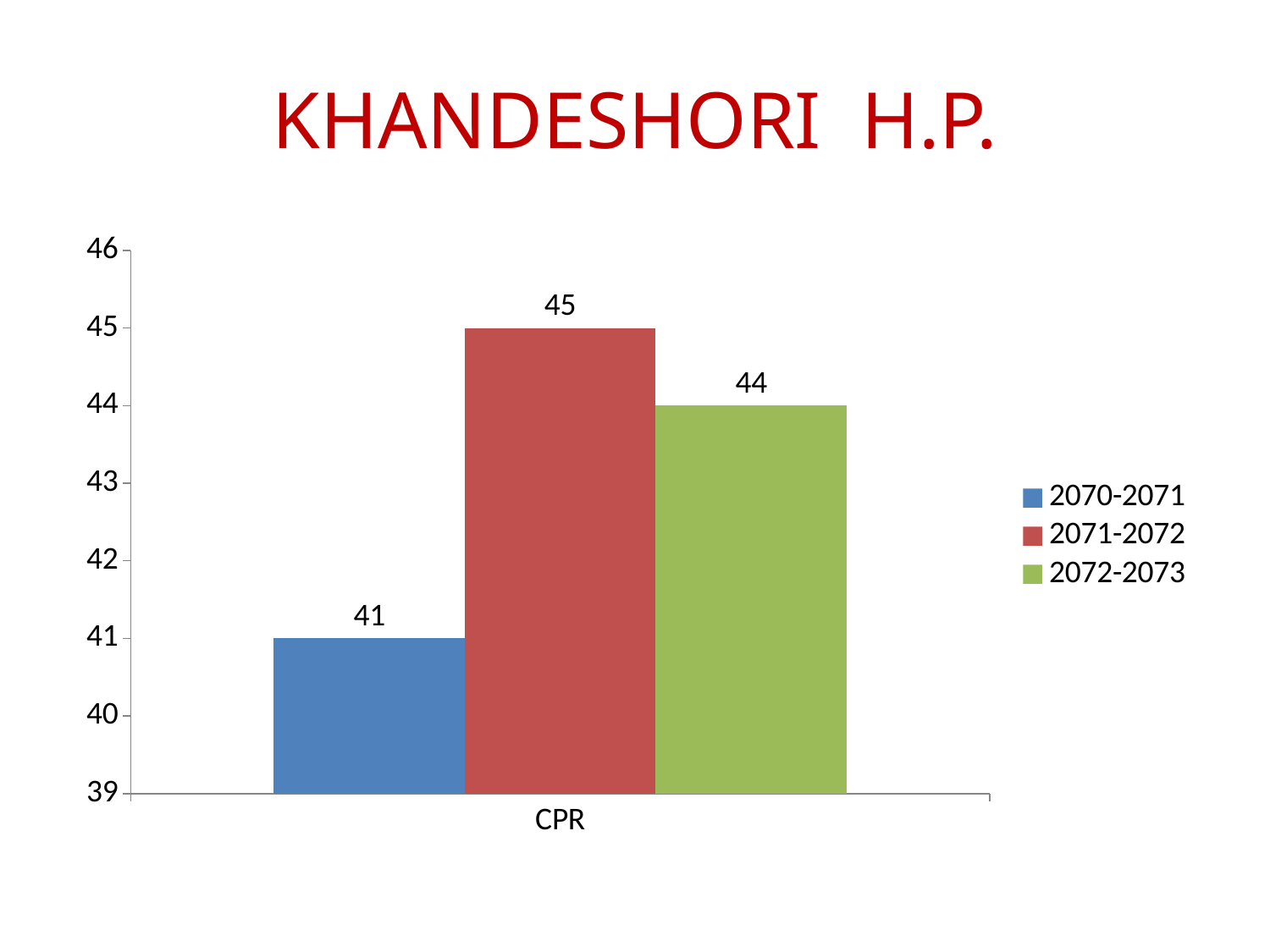
What is the title of the slide? KHANDESHORI H.P. Which series has the lowest CPR value? 2070-2071 What is the CPR value for 2072-2073? 44 What is the difference between the CPR values for 2071-2072 and 2072-2073? 1 How many series does the legend list? 3 Which is larger, the CPR value for 2072-2073 or for 2070-2071? 2072-2073 What is the difference between the CPR values for 2071-2072 and 2070-2071? 4 What is the CPR value for 2071-2072? 45 Which series has the highest CPR value? 2071-2072 What is the CPR value for 2070-2071? 41 Is the CPR value for 2070-2071 greater or less than 42? less What kind of chart is shown on the slide? bar chart